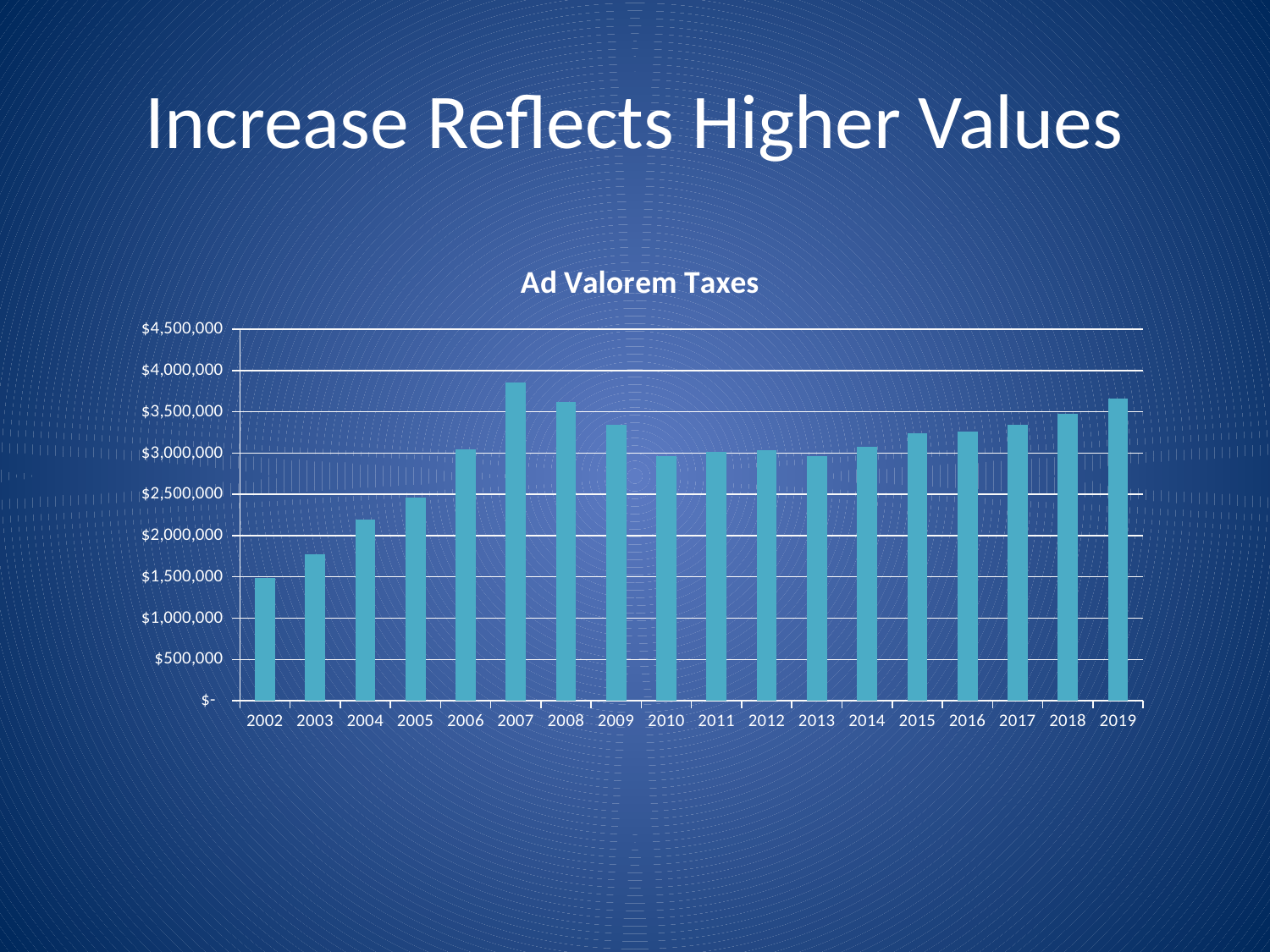
Is the value for 2004 greater or less than $2,000,000? greater Which year has the lowest Ad Valorem Taxes? 2002 What kind of chart is shown on the slide? bar chart What is the title of the chart? Ad Valorem Taxes Which year has the larger value, 2007 or 2008? 2007 Is the value for 2009 greater or less than $3,500,000? less Is the value for 2015 greater or less than $3,000,000? greater Do the values rise or fall from 2002 to 2007? rise Which year has the highest Ad Valorem Taxes? 2007 Which year has the larger value, 2004 or 2005? 2005 How many years are shown on the x axis of the chart? 18